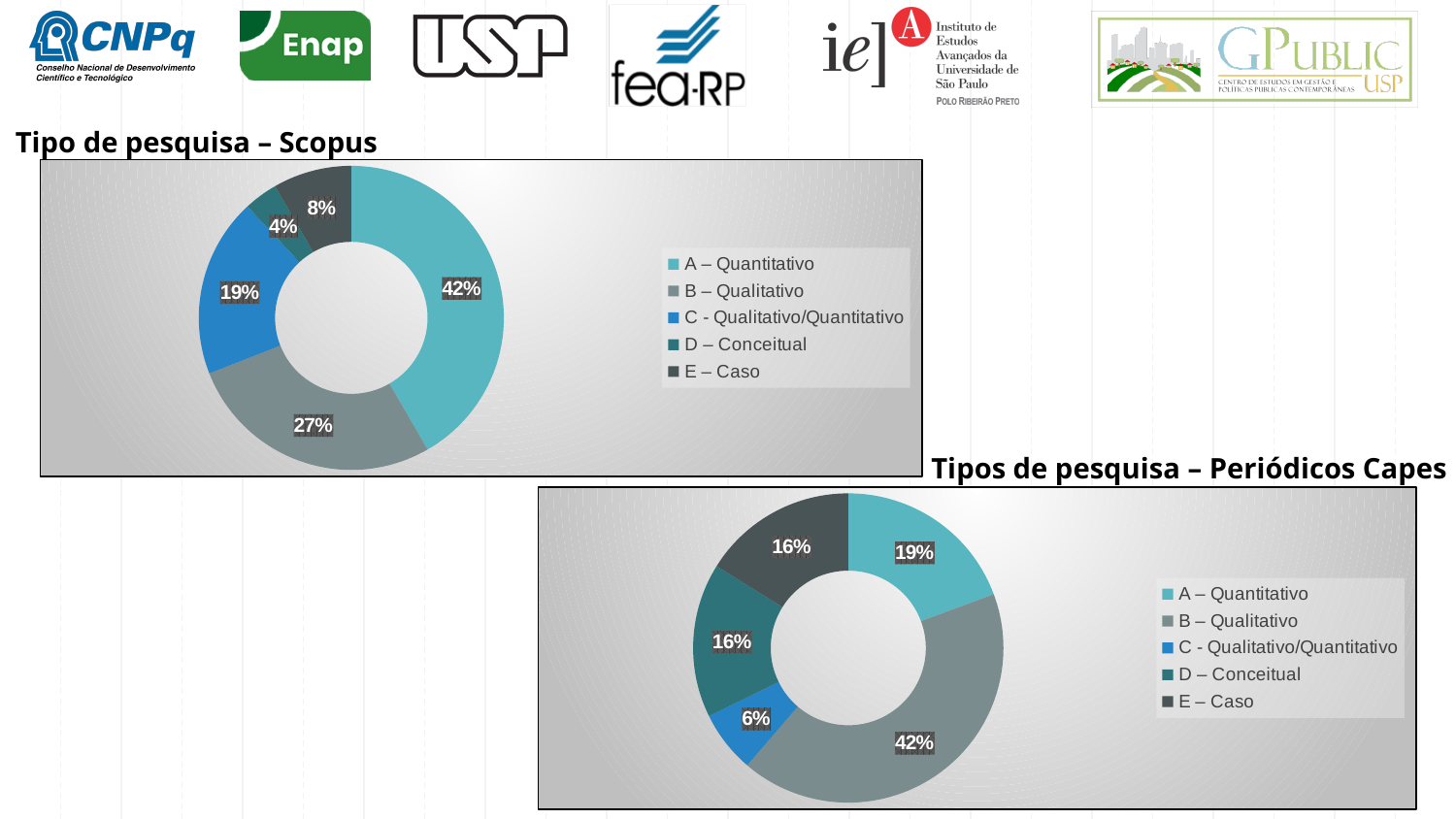
In the 'Tipos de pesquisa – Periódicos Capes' chart, what share does 'C - Qualitativo/Quantitativo' have? 6% In the 'Tipos de pesquisa – Periódicos Capes' chart, what share does 'B – Qualitativo' have? 42% In the 'Tipo de pesquisa – Scopus' chart, which category has the smallest share? D – Conceitual In the 'Tipos de pesquisa – Periódicos Capes' chart, what is the difference between the shares of 'B – Qualitativo' and 'A – Quantitativo'? 23% How many categories does the legend of the 'Tipo de pesquisa – Scopus' chart list? 5 In the 'Tipo de pesquisa – Scopus' chart, which category has the largest share? A – Quantitativo In the 'Tipo de pesquisa – Scopus' chart, what is the difference between the shares of 'A – Quantitativo' and 'B – Qualitativo'? 15% In the 'Tipo de pesquisa – Scopus' chart, what share does 'C - Qualitativo/Quantitativo' have? 19% In the 'Tipo de pesquisa – Scopus' chart, what share does 'A – Quantitativo' have? 42% What kind of chart is 'Tipos de pesquisa – Periódicos Capes'? Doughnut chart In the 'Tipos de pesquisa – Periódicos Capes' chart, which is larger, the share of 'A – Quantitativo' or 'D – Conceitual'? A – Quantitativo In the 'Tipos de pesquisa – Periódicos Capes' chart, which category has the largest share? B – Qualitativo